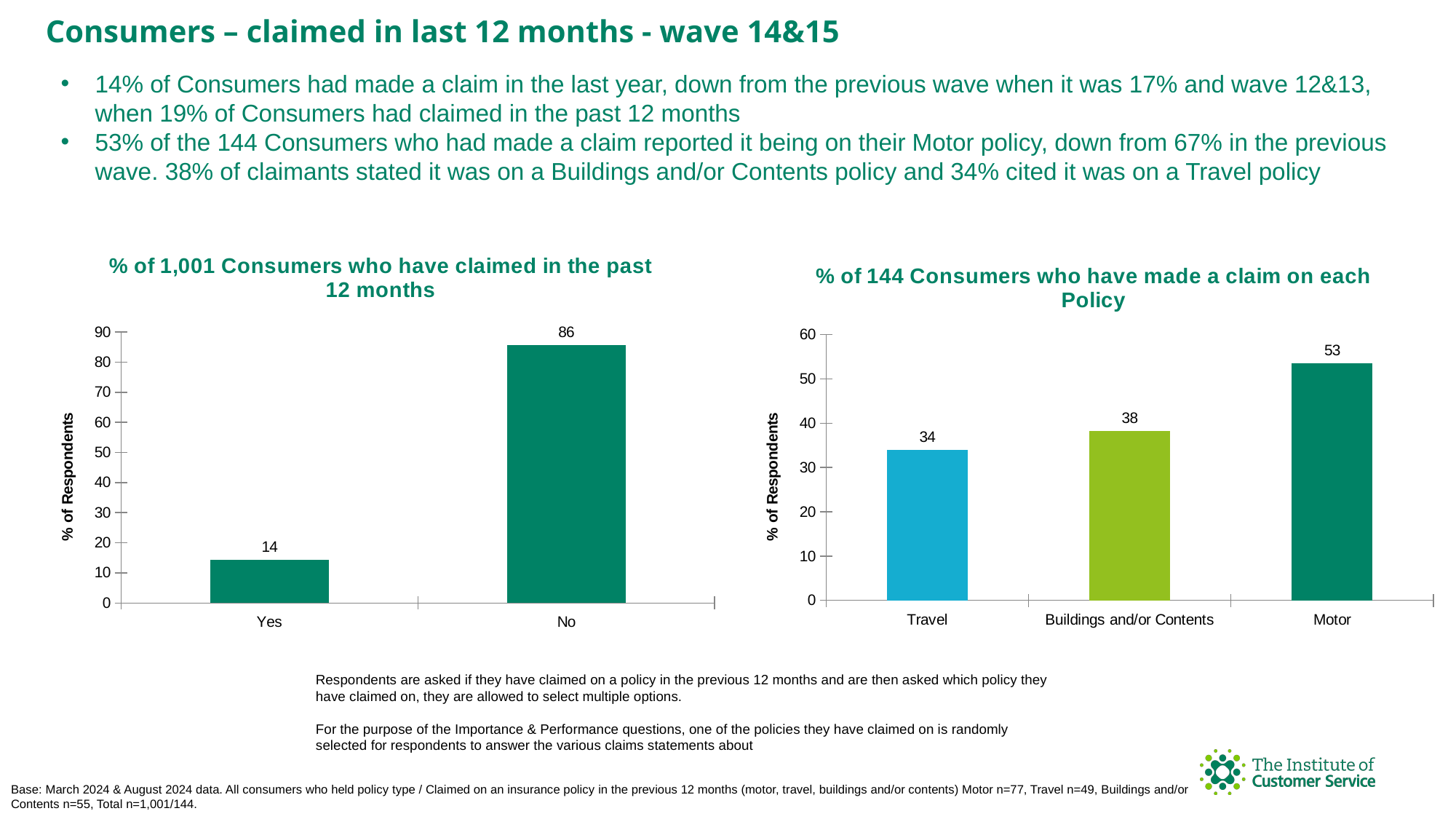
What kind of chart is the right chart '% of 144 Consumers who have made a claim on each Policy'? bar chart In the right chart '% of 144 Consumers who have made a claim on each Policy', what is the value for Travel? 34 In the right chart '% of 144 Consumers who have made a claim on each Policy', which policy has the highest value? Motor In the right chart '% of 144 Consumers who have made a claim on each Policy', what is the difference between the Motor and Travel values? 19 In the left chart '% of 1,001 Consumers who have claimed in the past 12 months', what is the value for Yes? 14 In the right chart '% of 144 Consumers who have made a claim on each Policy', do the values rise or fall from left to right along the x axis? rise In the left chart '% of 1,001 Consumers who have claimed in the past 12 months', what is the value for No? 86 In the right chart '% of 144 Consumers who have made a claim on each Policy', which policy has the lowest value? Travel In the left chart '% of 1,001 Consumers who have claimed in the past 12 months', what is the difference between the No and Yes values? 72 In the right chart '% of 144 Consumers who have made a claim on each Policy', is the value for Motor greater or less than 50? greater In the right chart '% of 144 Consumers who have made a claim on each Policy', what is the value for Buildings and/or Contents? 38 In the left chart '% of 1,001 Consumers who have claimed in the past 12 months', how many categories are shown on the x axis? 2